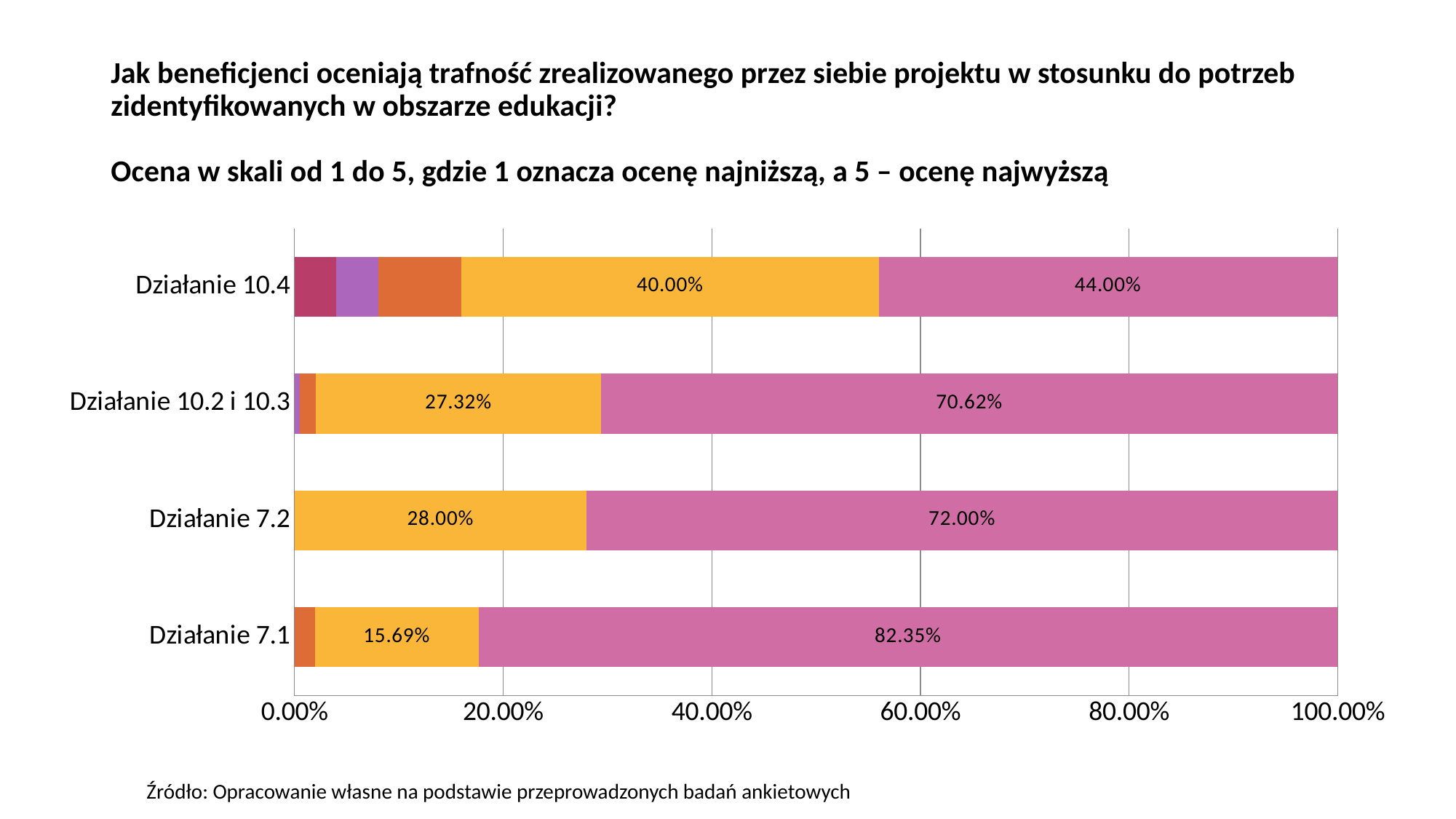
What is the value of the pink segment for Działanie 10.2 i 10.3? 70.62% Which category has the largest pink segment? Działanie 7.1 What is the value of the yellow segment for Działanie 7.1? 15.69% Which category has the smallest pink segment? Działanie 10.4 How many categories (Działanie groups) are shown on the chart? 4 What is the value of the yellow segment for Działanie 10.4? 40.00% How many coloured segments make up the bar for Działanie 10.4? 5 What kind of chart is shown on the slide? bar chart Is the combined value of the yellow and pink segments for Działanie 10.4 greater or less than 80.00%? greater For Działanie 7.2, what is the difference between the pink segment and the yellow segment? 44.00% Which has the larger yellow segment, Działanie 7.2 or Działanie 10.2 i 10.3? Działanie 7.2 What is the value of the pink segment for Działanie 7.1? 82.35%